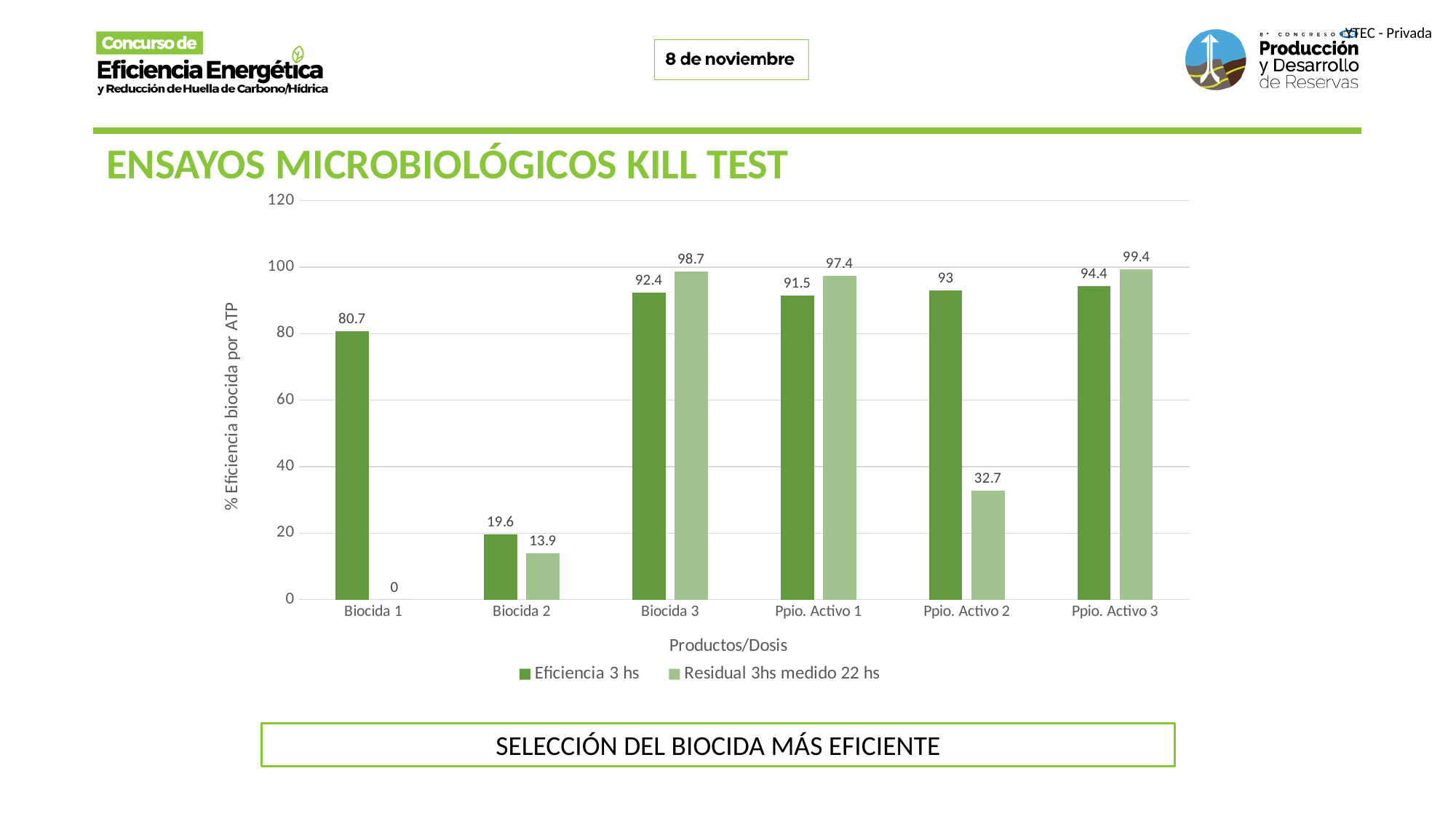
Is the Eficiencia 3 hs value for Biocida 2 greater or less than 40? less How many series does the legend list? 2 What is the label of the y axis? % Eficiencia biocida por ATP What kind of chart is shown on the slide? bar chart How many categories are shown on the x axis? 6 Which category has the lowest Eficiencia 3 hs value? Biocida 2 What is the Eficiencia 3 hs value for Biocida 1? 80.7 What is the Residual 3hs medido 22 hs value for Ppio. Activo 2? 32.7 Which is larger for Ppio. Activo 2: Eficiencia 3 hs or Residual 3hs medido 22 hs? Eficiencia 3 hs Which category has the highest Residual 3hs medido 22 hs value? Ppio. Activo 3 What is the Residual 3hs medido 22 hs value for Biocida 1? 0 What is the difference between the Residual 3hs medido 22 hs and Eficiencia 3 hs values for Biocida 3? 6.3